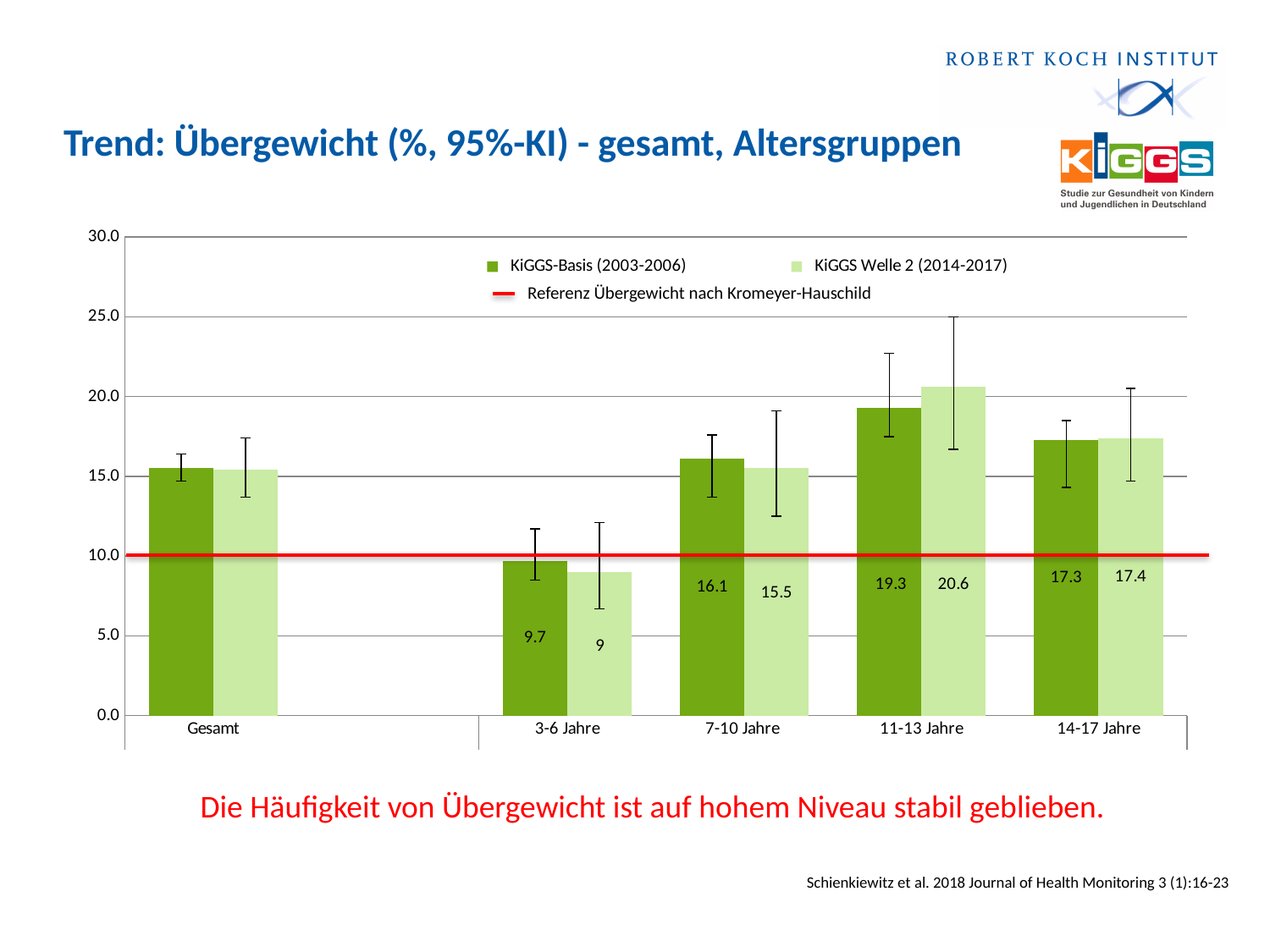
What is the value for KiGGS Welle 2 (2014-2017) in the 7-10 Jahre age group? 15.5 What is the value for KiGGS Welle 2 (2014-2017) in the 11-13 Jahre age group? 20.6 Which age group has the highest value for KiGGS Welle 2 (2014-2017)? 11-13 Jahre How many entries does the chart legend list? 3 What is the value for KiGGS-Basis (2003-2006) in the 3-6 Jahre age group? 9.7 How many categories are shown on the x axis of the chart? 5 In the 11-13 Jahre age group, how much higher is the KiGGS Welle 2 (2014-2017) value than the KiGGS-Basis (2003-2006) value? 1.3 In the 7-10 Jahre age group, which series has the larger value, KiGGS-Basis (2003-2006) or KiGGS Welle 2 (2014-2017)? KiGGS-Basis (2003-2006) In the 3-6 Jahre age group, what is the difference between the KiGGS-Basis (2003-2006) and KiGGS Welle 2 (2014-2017) values? 0.7 What kind of chart is shown on the slide? bar chart Which age group has the lowest value for KiGGS-Basis (2003-2006)? 3-6 Jahre Is the value for KiGGS-Basis (2003-2006) in the Gesamt group greater or less than 10.0? greater